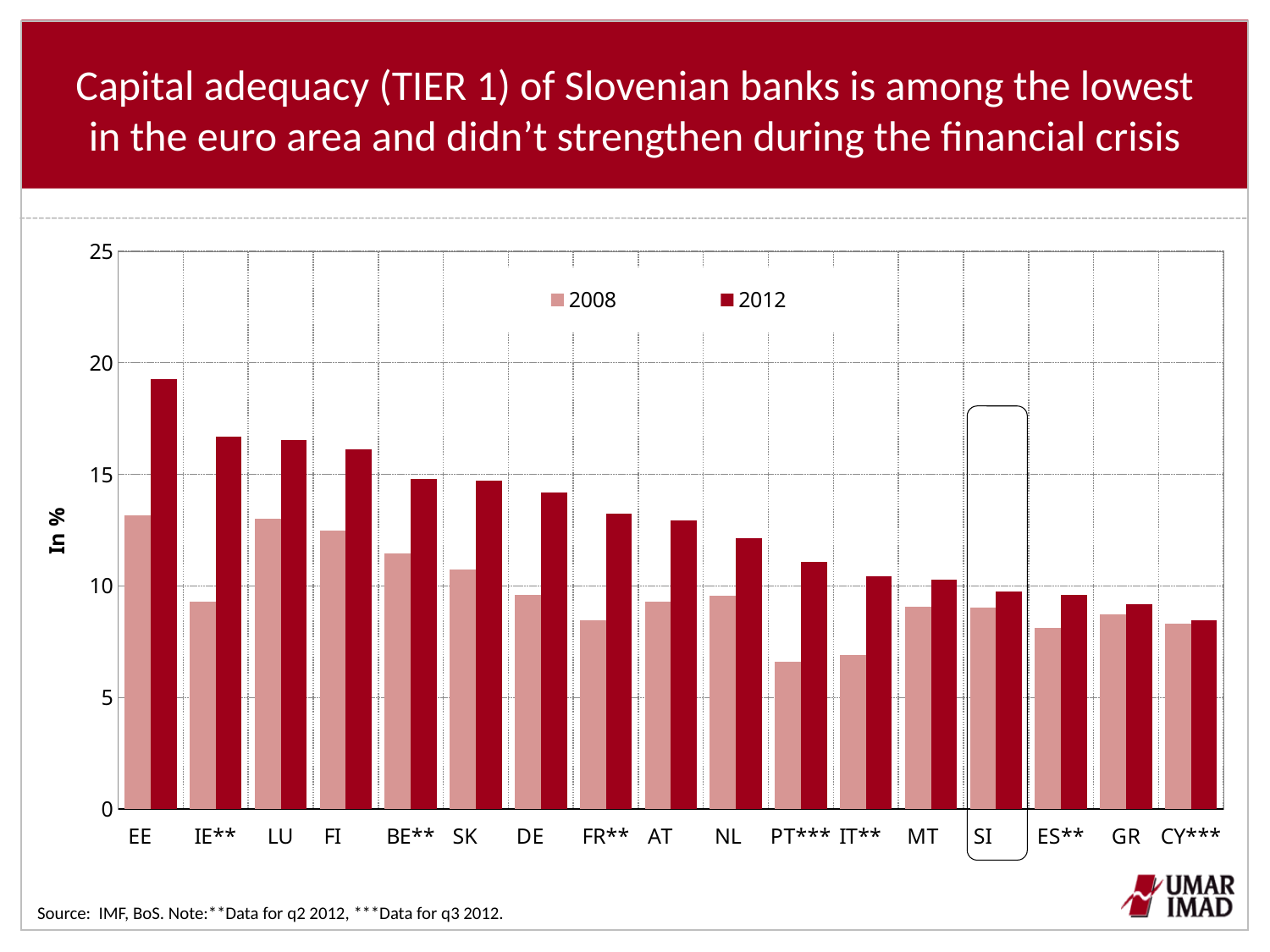
Which is larger for 2012: NL or SI? NL Is the 2008 value for PT*** greater or less than 10? less For SK, which year has the larger value, 2008 or 2012? 2012 Which country has the highest 2012 value? EE Which country is highlighted with a box on the chart? SI Is the 2012 value for DE greater or less than 10? greater What kind of chart is shown on the slide? bar chart How many series does the legend list? 2 Is the 2012 value for EE greater or less than 15? greater Which country has the lowest 2012 value? CY*** How many countries are shown on the x axis? 17